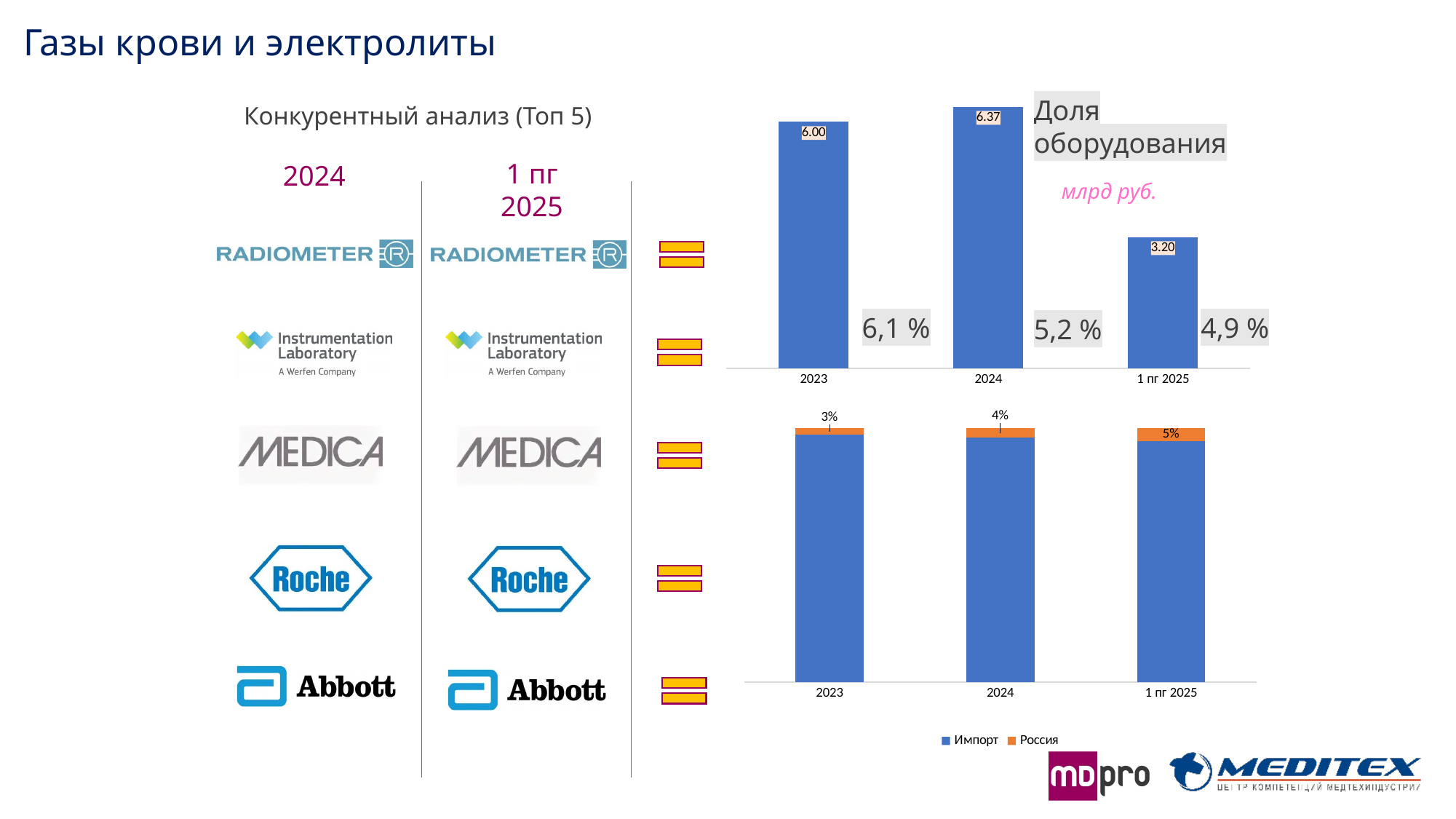
In the top chart (Доля оборудования), which is larger: the value for 2023 or for 1 пг 2025? 2023 In the top chart (Доля оборудования), what percentage is shown next to the 2023 bar? 6,1 % In the top chart (Доля оборудования), what is the value for 1 пг 2025? 3.20 In the top chart (Доля оборудования), what is the difference between the 2024 and 2023 values? 0.37 In the top chart (Доля оборудования), which category has the lowest value? 1 пг 2025 In the bottom stacked chart, what is the Россия share for 1 пг 2025? 5% In the bottom stacked chart, how many series does the legend list? 2 In the bottom stacked chart, does the Россия share rise or fall from 2023 to 1 пг 2025? rise In the top chart (Доля оборудования), which category has the highest value? 2024 In the top chart (Доля оборудования), what is the value for 2024? 6.37 In the top chart (Доля оборудования), what unit is indicated for the values? млрд руб. In the top chart (Доля оборудования), what is the value for 2023? 6.00